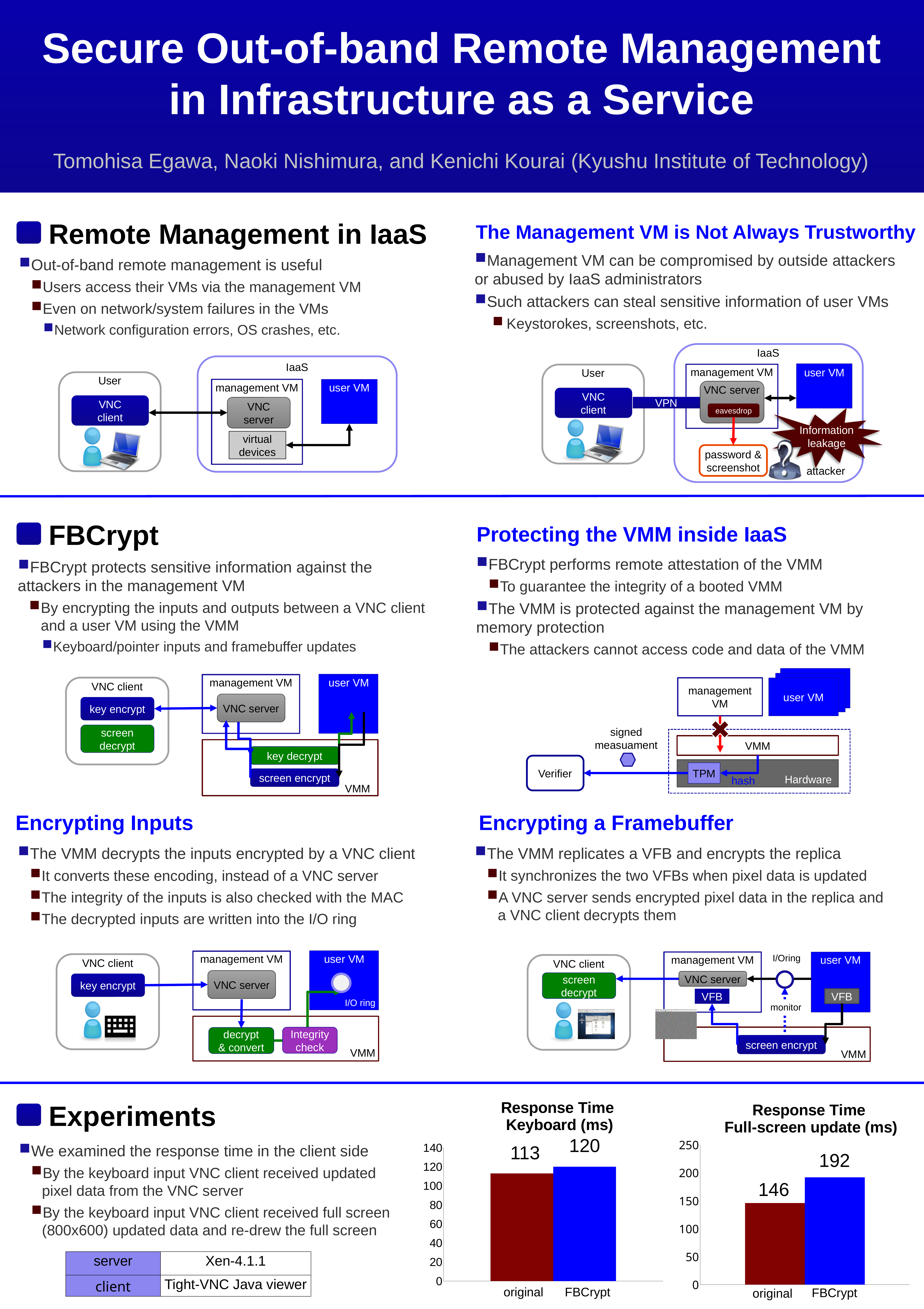
In the Response Time Full-screen update (ms) chart, what is the difference between the FBCrypt and original values? 46 In the Response Time Full-screen update (ms) chart, what is the value for original? 146 In the Response Time Full-screen update (ms) chart, is the value for original greater or less than 150? less In the Response Time Keyboard (ms) chart, what is the value for original? 113 In the Response Time Keyboard (ms) chart, what is the value for FBCrypt? 120 What kind of chart is the Response Time Full-screen update (ms) chart? bar chart In the Response Time Full-screen update (ms) chart, what is the value for FBCrypt? 192 In the Response Time Full-screen update (ms) chart, which category has the highest value? FBCrypt In the Response Time Keyboard (ms) chart, what colour is the bar for original? dark red In the Response Time Keyboard (ms) chart, what is the difference between the FBCrypt and original values? 7 In the Response Time Keyboard (ms) chart, which category has the lowest value? original How many categories are shown in the Response Time Keyboard (ms) chart? 2